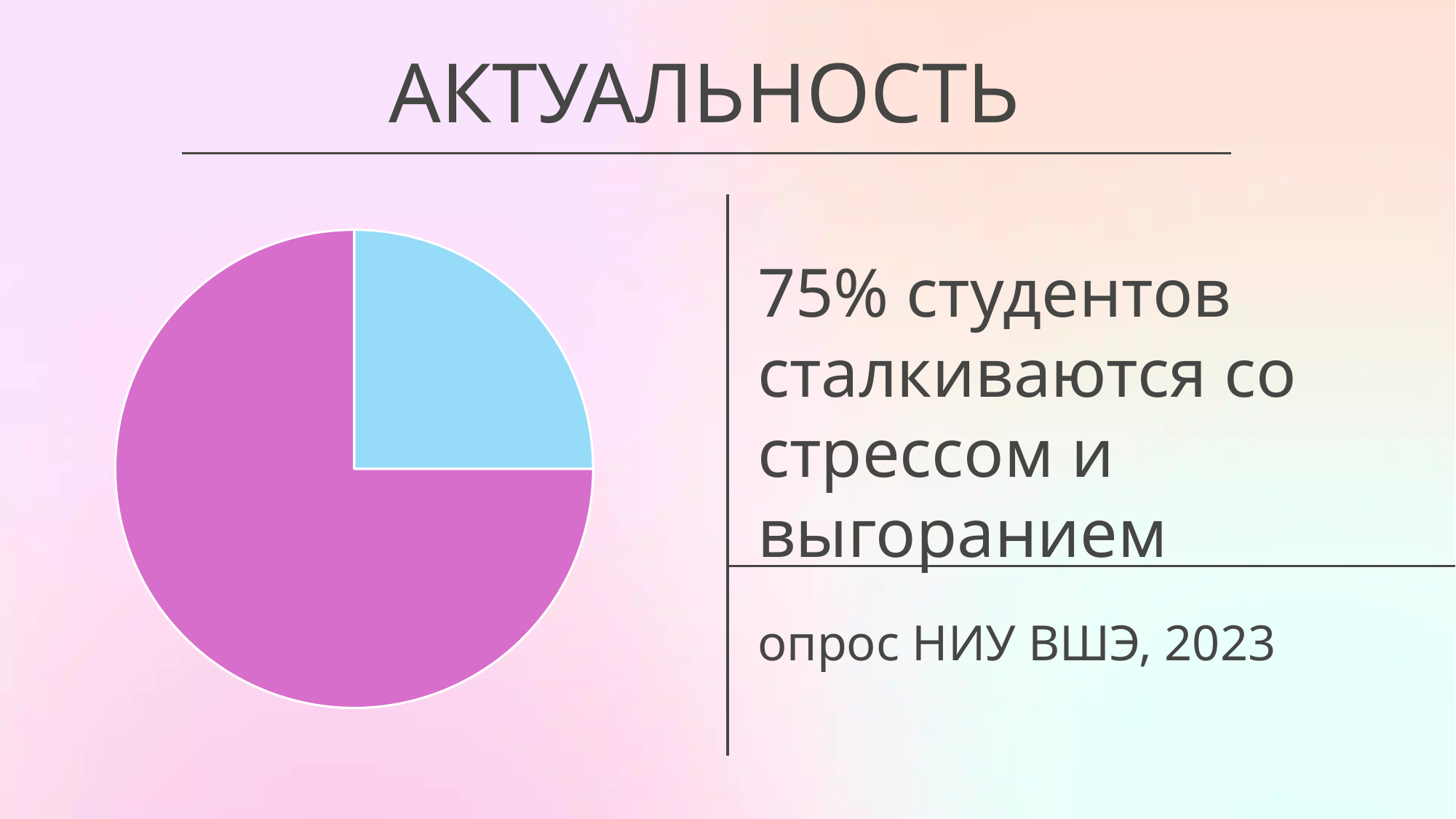
Is the light blue slice larger or smaller than the pink slice? smaller Which slice of the pie chart is the smallest? the light blue slice How many slices does the pie chart have? 2 What source is cited for the data shown in the pie chart? опрос НИУ ВШЭ, 2023 What kind of chart is shown on the slide? pie chart Does the pink slice cover more or less than half of the pie? more What is the title of the slide containing the pie chart? АКТУАЛЬНОСТЬ Which slice of the pie chart is the largest? the pink (magenta) slice According to the slide, what share of students face stress and burnout, as represented by the large pink slice? 75%